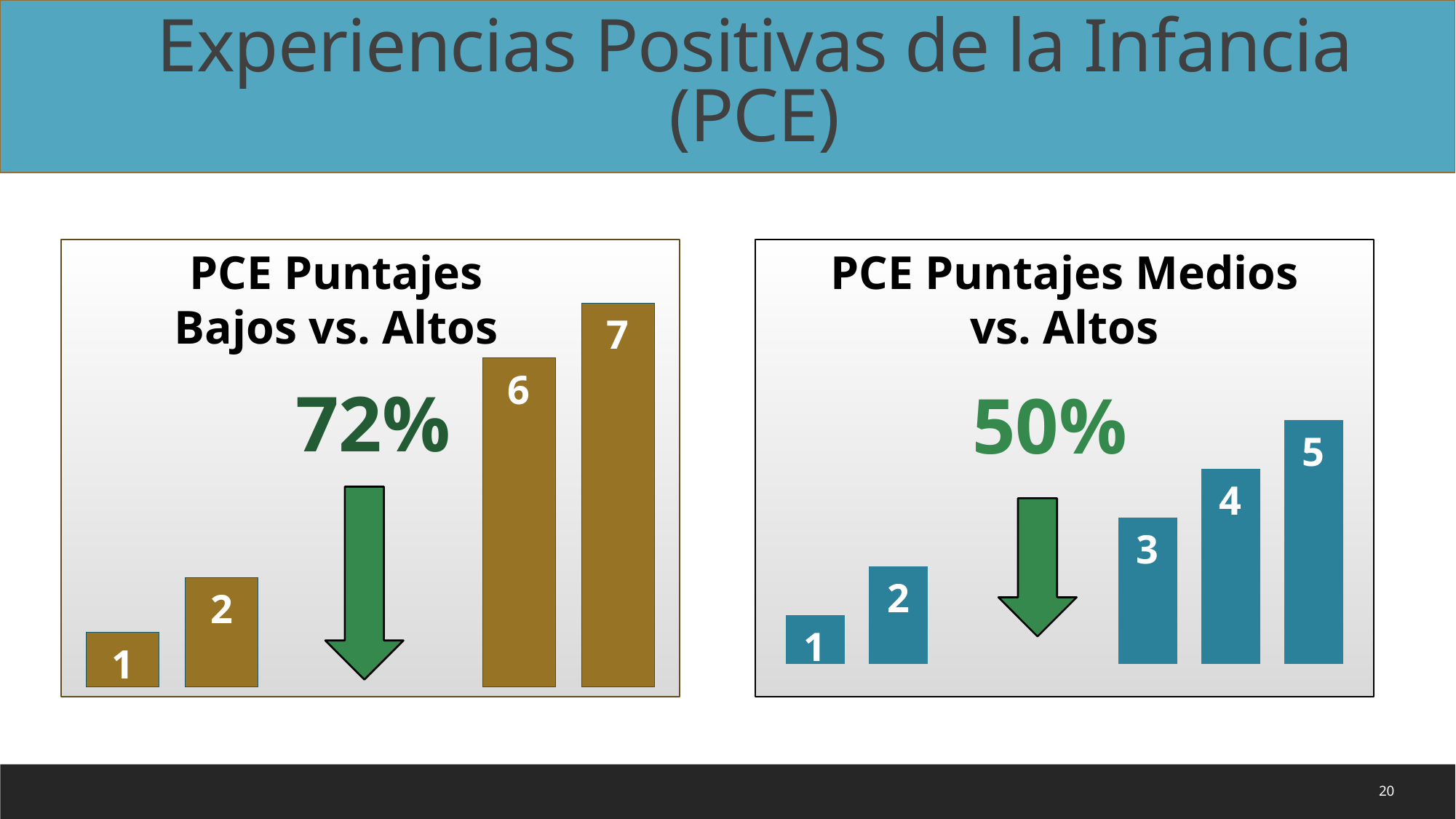
In the chart titled "PCE Puntajes Bajos vs. Altos", what is the difference between the bar labeled 7 and the bar labeled 2? 5 In the chart titled "PCE Puntajes Medios vs. Altos", how many bars are shown? 5 In the chart titled "PCE Puntajes Bajos vs. Altos", what percentage is printed next to the green arrow? 72% In the chart titled "PCE Puntajes Bajos vs. Altos", what is the label on the tallest bar? 7 In the chart titled "PCE Puntajes Medios vs. Altos", what is the label on the tallest bar? 5 In the chart titled "PCE Puntajes Bajos vs. Altos", how many bars are shown? 4 In the chart titled "PCE Puntajes Medios vs. Altos", do the bar values rise or fall from left to right? Rise What kind of chart is shown on the left side of the slide? Bar chart In the chart titled "PCE Puntajes Medios vs. Altos", what is the label on the shortest bar? 1 In the chart titled "PCE Puntajes Bajos vs. Altos", what is the label on the shortest bar? 1 In the chart titled "PCE Puntajes Medios vs. Altos", what percentage is printed next to the green arrow? 50% What colour are the bars in the chart titled "PCE Puntajes Medios vs. Altos"? Blue